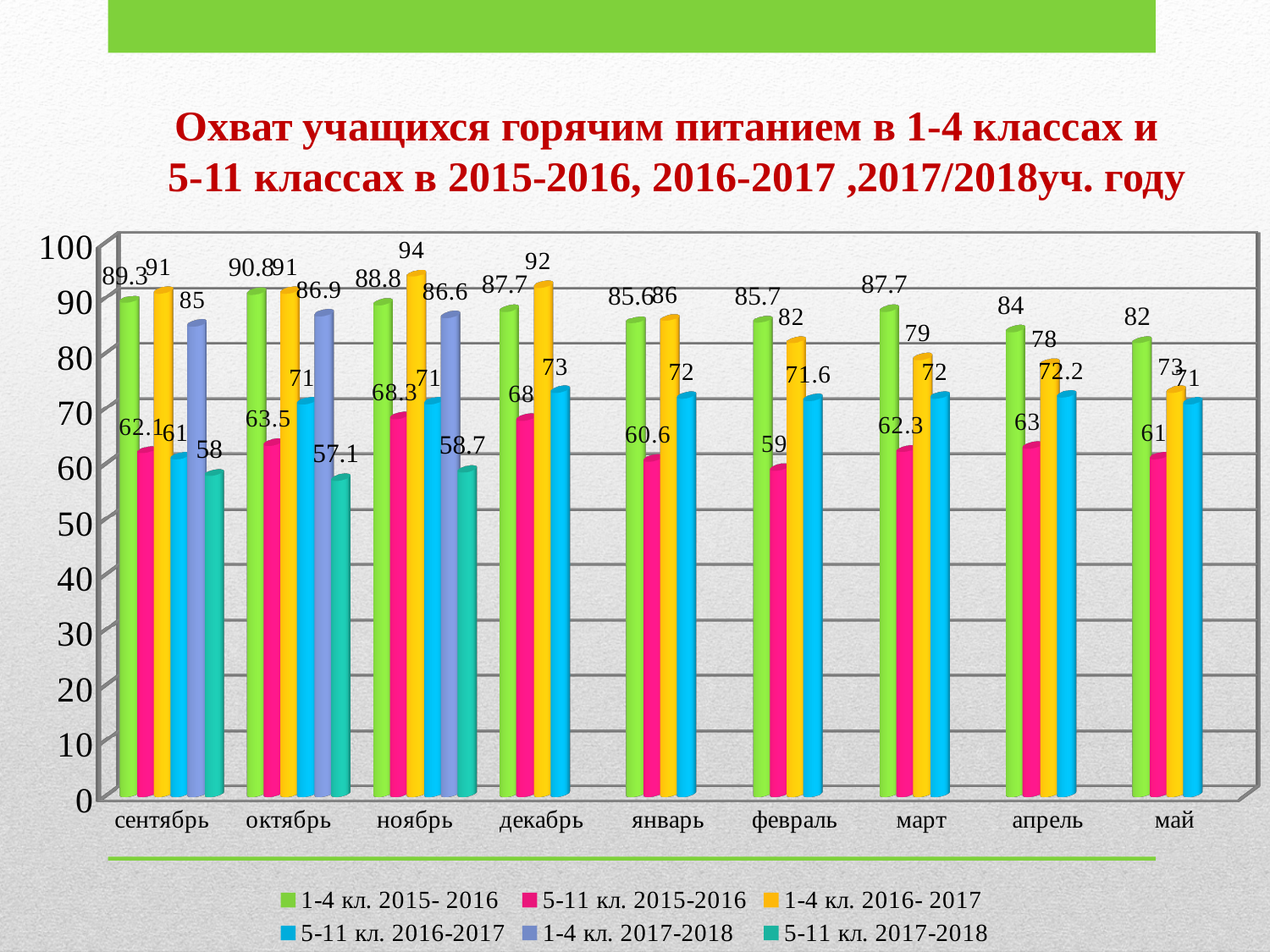
Is the value for 1-4 кл. 2017-2018 in сентябрь greater or less than 80? greater Do the values for 1-4 кл. 2016- 2017 rise or fall from декабрь to май? fall In май, which is larger: 5-11 кл. 2016-2017 or 5-11 кл. 2015-2016? 5-11 кл. 2016-2017 What is the value for 5-11 кл. 2017-2018 in октябрь? 57.1 What is the value for 5-11 кл. 2015-2016 in март? 62.3 How many months are shown on the x axis? 9 What kind of chart is shown on the slide? bar chart What is the value for 1-4 кл. 2016- 2017 in ноябрь? 94 What is the difference between 1-4 кл. 2015- 2016 and 5-11 кл. 2015-2016 in сентябрь? 27.2 How many series does the legend list? 6 In which month is the value for 1-4 кл. 2016- 2017 the highest? ноябрь In which month is the value for 5-11 кл. 2015-2016 the lowest? февраль